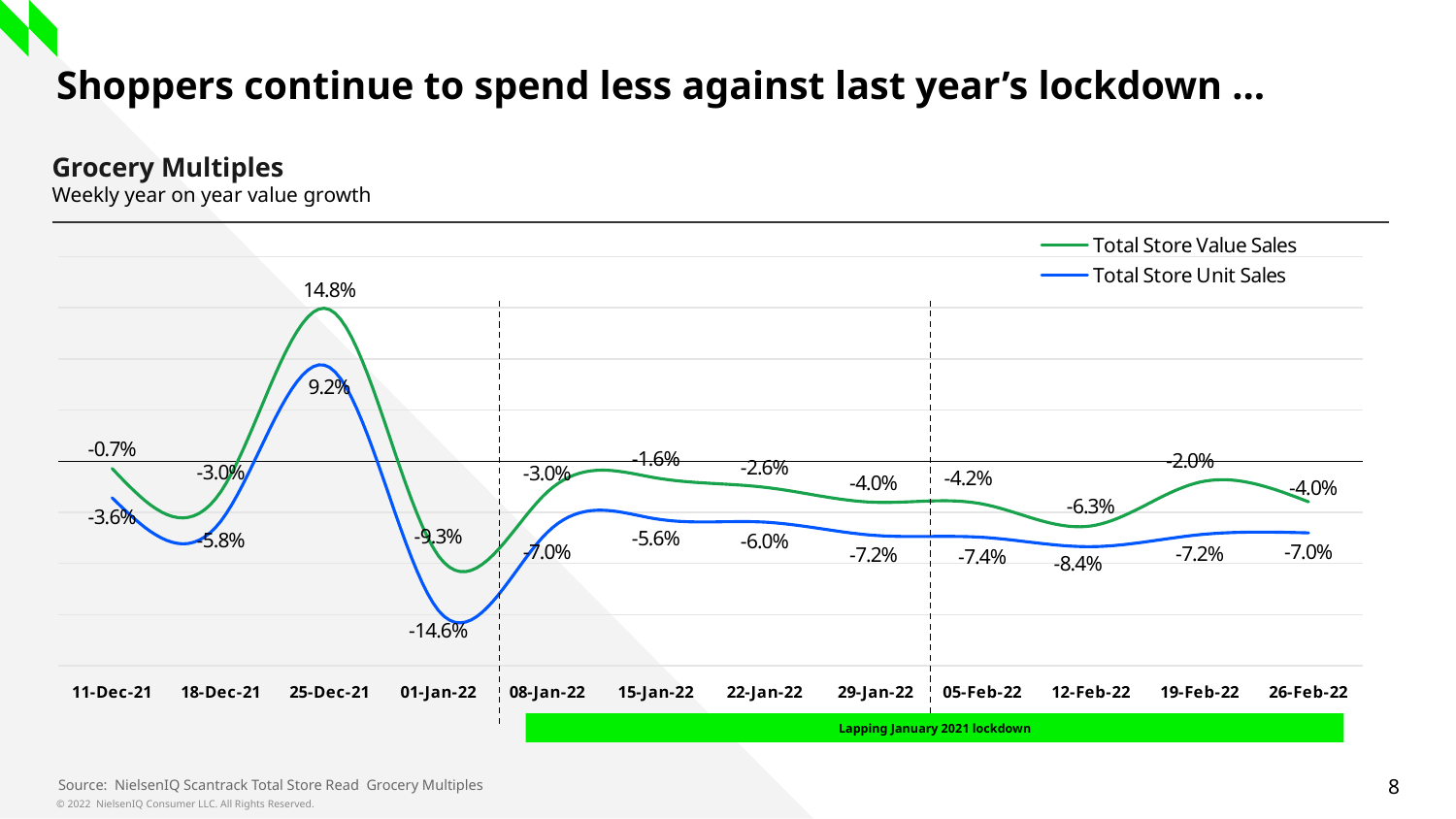
Does Total Store Value Sales growth rise or fall from 15-Jan-22 to 12-Feb-22? Fall How many series does the legend list? 2 For 12-Feb-22, which series has the higher growth, Total Store Value Sales or Total Store Unit Sales? Total Store Value Sales What is the Total Store Unit Sales growth for 12-Feb-22? -8.4% What is the Total Store Unit Sales growth for 01-Jan-22? -14.6% In which week is Total Store Unit Sales growth lowest? 01-Jan-22 What is the Total Store Value Sales growth for 26-Feb-22? -4.0% What is the Total Store Value Sales growth for 25-Dec-21? 14.8% What is the difference between Total Store Value Sales and Total Store Unit Sales growth for 25-Dec-21? 5.6 percentage points In which week is Total Store Value Sales growth highest? 25-Dec-21 How many weeks are plotted on the x axis? 12 What kind of chart is shown on the slide? Line chart